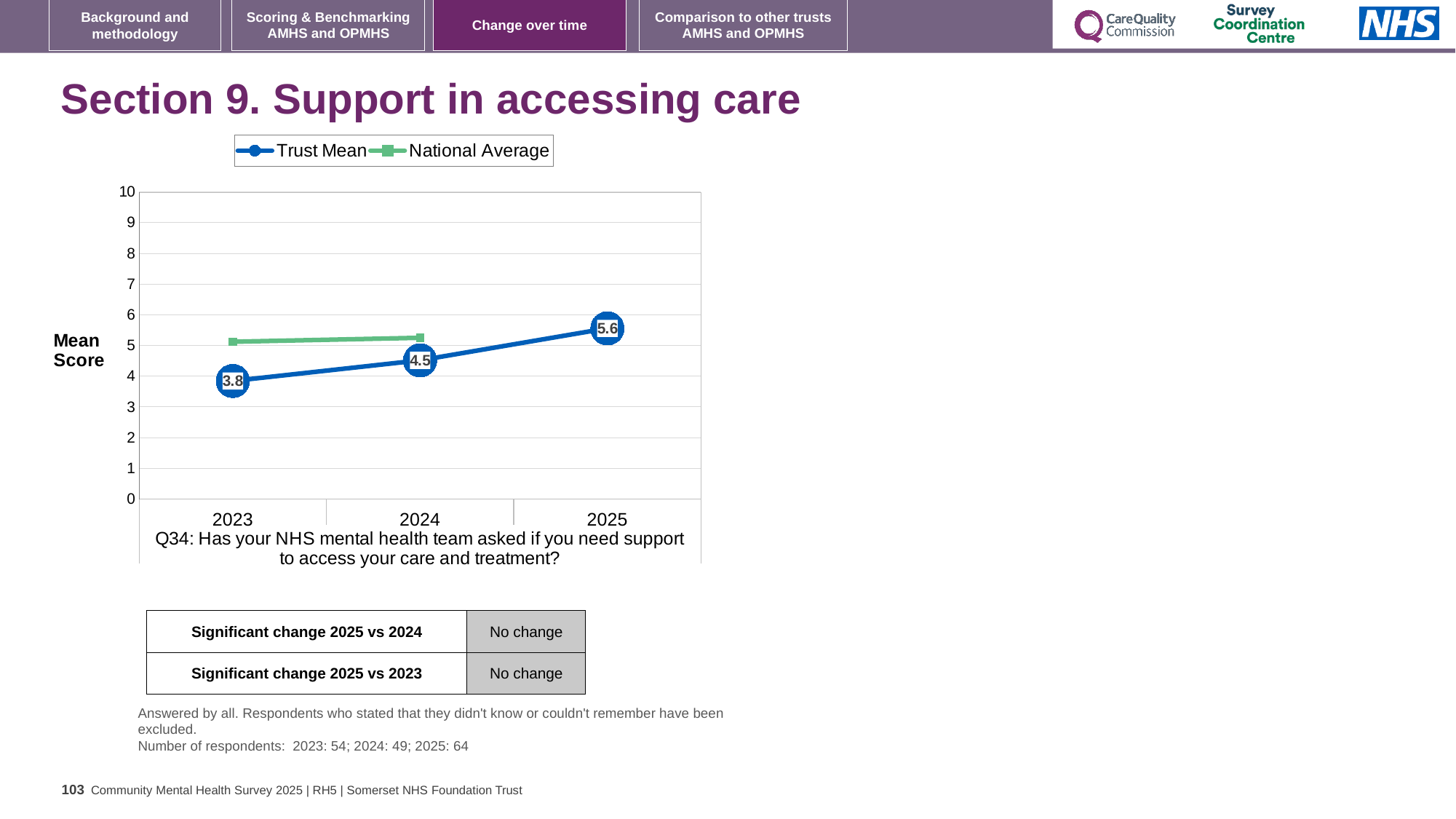
What kind of chart is shown on the slide? line chart In which year is the Trust Mean score lowest? 2023 What is the Trust Mean score for 2024? 4.5 In which year is the Trust Mean score highest? 2025 How many years are shown on the x axis of the chart? 3 What is the Trust Mean score for 2023? 3.8 Does the Trust Mean score rise or fall from 2023 to 2025? rise Is the National Average value for 2024 greater or less than 6? less Which is larger, the Trust Mean score for 2024 or for 2025? 2025 By how much did the Trust Mean score increase from 2023 to 2025? 1.8 How many series does the chart legend list? 2 What is the Trust Mean score for 2025? 5.6